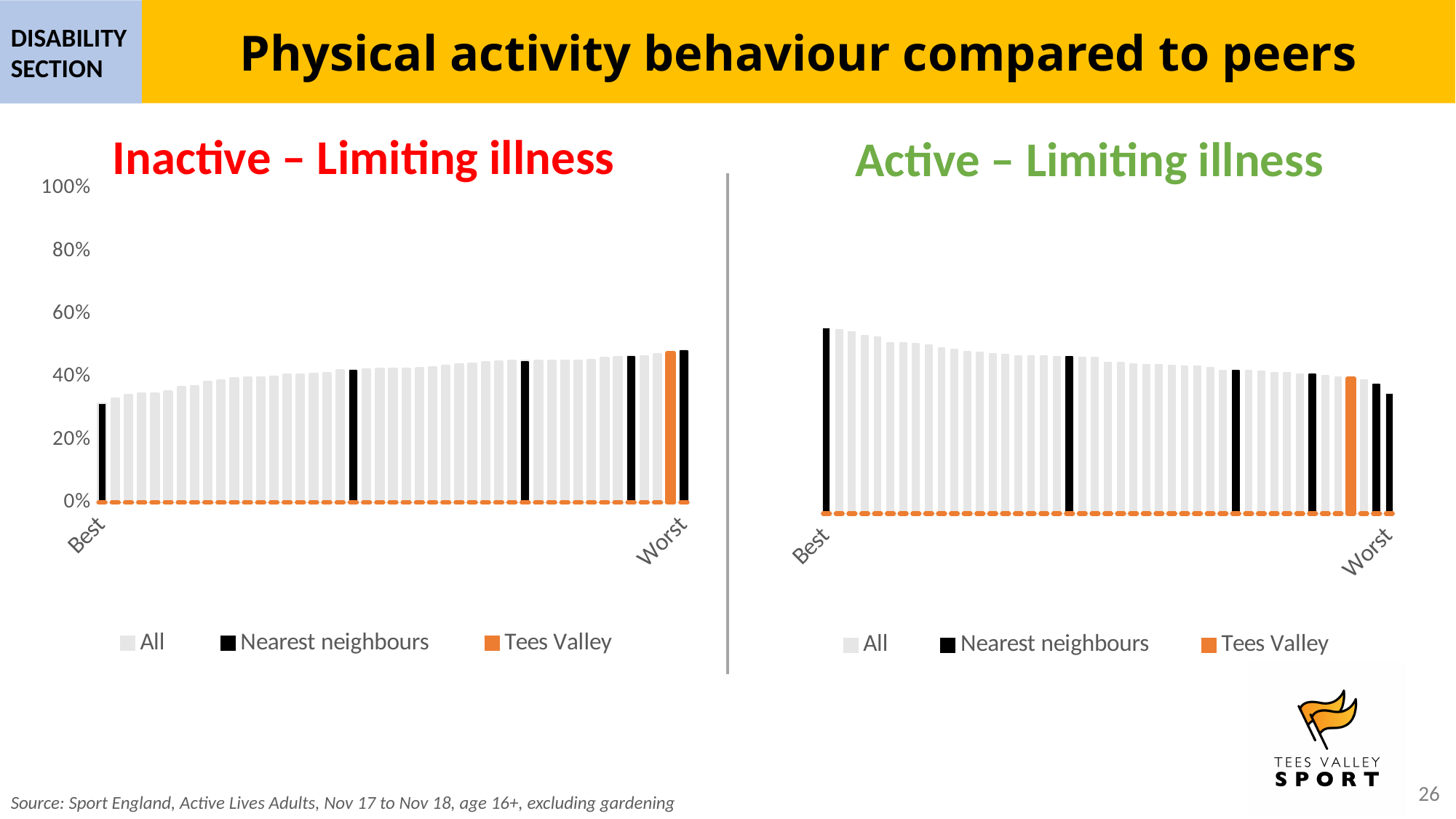
How many series does the legend of the 'Inactive – Limiting illness' chart list? 3 In the 'Active – Limiting illness' chart, do the bar values rise or fall from Best to Worst? Fall In the 'Inactive – Limiting illness' chart, do the bar values rise or fall from Best to Worst? Rise What type of chart is used for 'Inactive – Limiting illness'? Bar chart What are the two labels shown on the x axis of the 'Active – Limiting illness' chart? Best and Worst In the 'Inactive – Limiting illness' chart, which is larger: the Tees Valley bar or the first bar at the Best end? Tees Valley In the 'Inactive – Limiting illness' chart, is the value of the first bar at the Best end greater or less than 40%? less In the 'Inactive – Limiting illness' chart, is the value for Tees Valley greater or less than 60%? less How many series does the legend of the 'Active – Limiting illness' chart list? 3 In the 'Inactive – Limiting illness' chart, is the value for Tees Valley greater or less than 40%? greater Which series is shown in orange in both charts? Tees Valley In the 'Active – Limiting illness' chart, which is larger: the Tees Valley bar or the first bar at the Best end? The first bar at the Best end